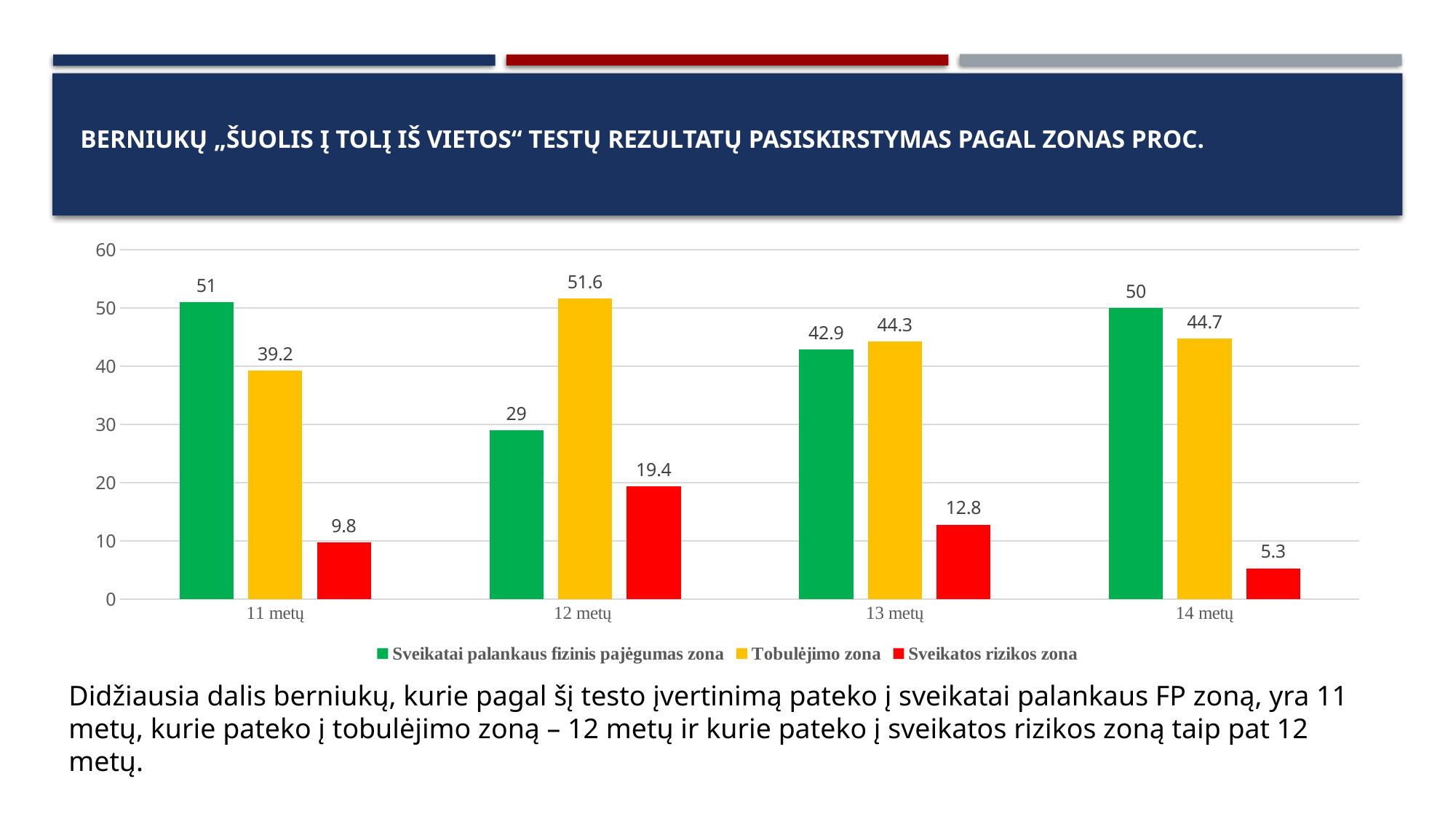
Which age group has the highest value for "Sveikatos rizikos zona"? 12 metų At 14 metų, which is larger: "Sveikatai palankaus fizinis pajėgumas zona" or "Tobulėjimo zona"? Sveikatai palankaus fizinis pajėgumas zona What is the difference between the "Tobulėjimo zona" value and the "Sveikatai palankaus fizinis pajėgumas zona" value at 13 metų? 1.4 What colour represents "Sveikatos rizikos zona" in the chart? red Which age group has the lowest value for "Sveikatai palankaus fizinis pajėgumas zona"? 12 metų What is the value for "Sveikatai palankaus fizinis pajėgumas zona" at 11 metų? 51 What is the value for "Tobulėjimo zona" at 12 metų? 51.6 What is the value for "Sveikatos rizikos zona" at 14 metų? 5.3 How many series does the legend list? 3 How many age groups are shown on the x axis? 4 What kind of chart is shown on the slide? bar chart Is the value for "Sveikatos rizikos zona" at 13 metų greater or less than 20? less